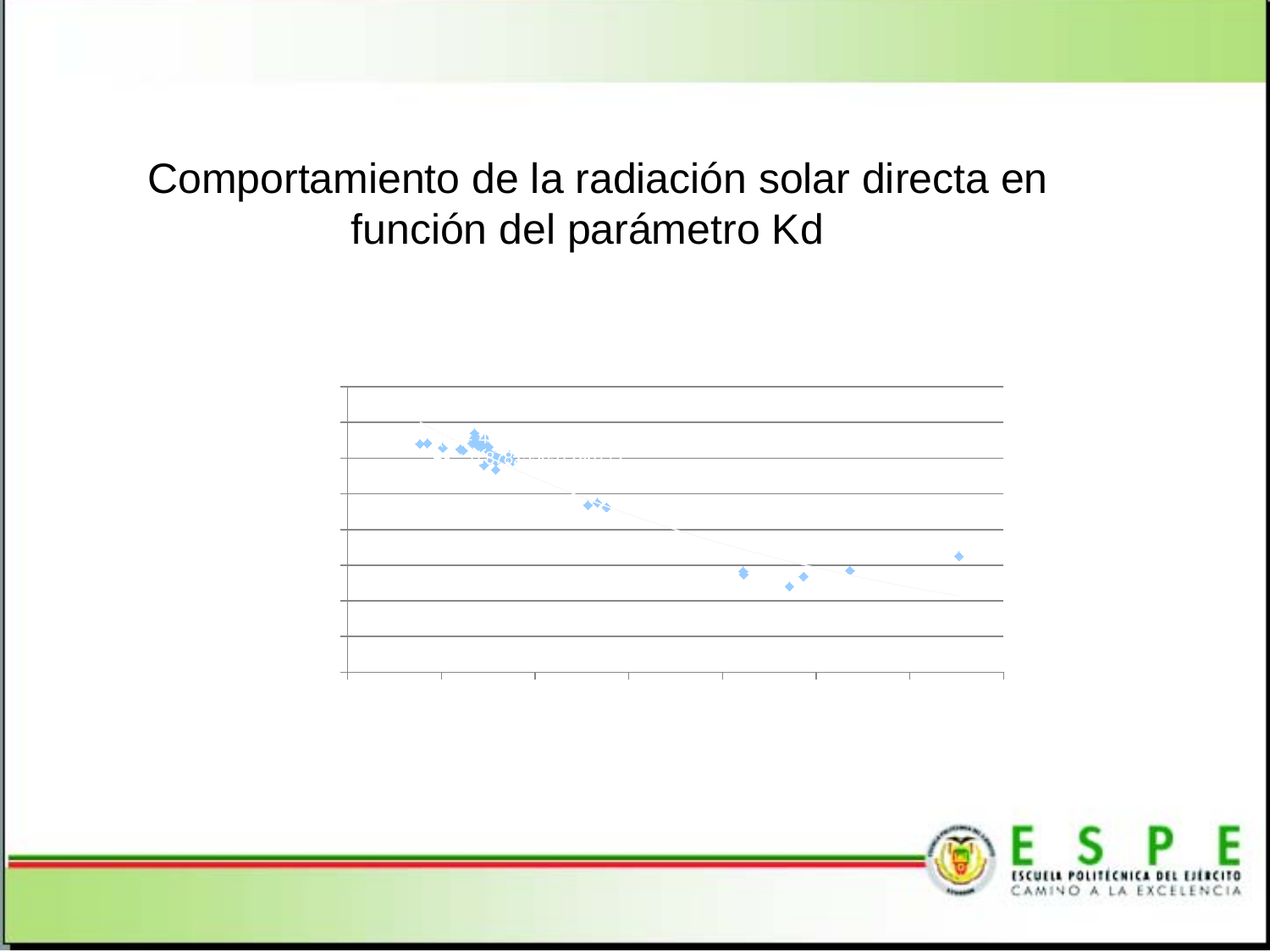
What is the title shown above the chart on the slide? Comportamiento de la radiación solar directa en función del parámetro Kd What kind of chart is shown on the slide? scatter chart What colour are the data point markers in the chart? blue Do the plotted values rise or fall as you move from left to right along the x axis? fall Are the plotted points on the left side of the chart higher or lower than the points on the right side? higher